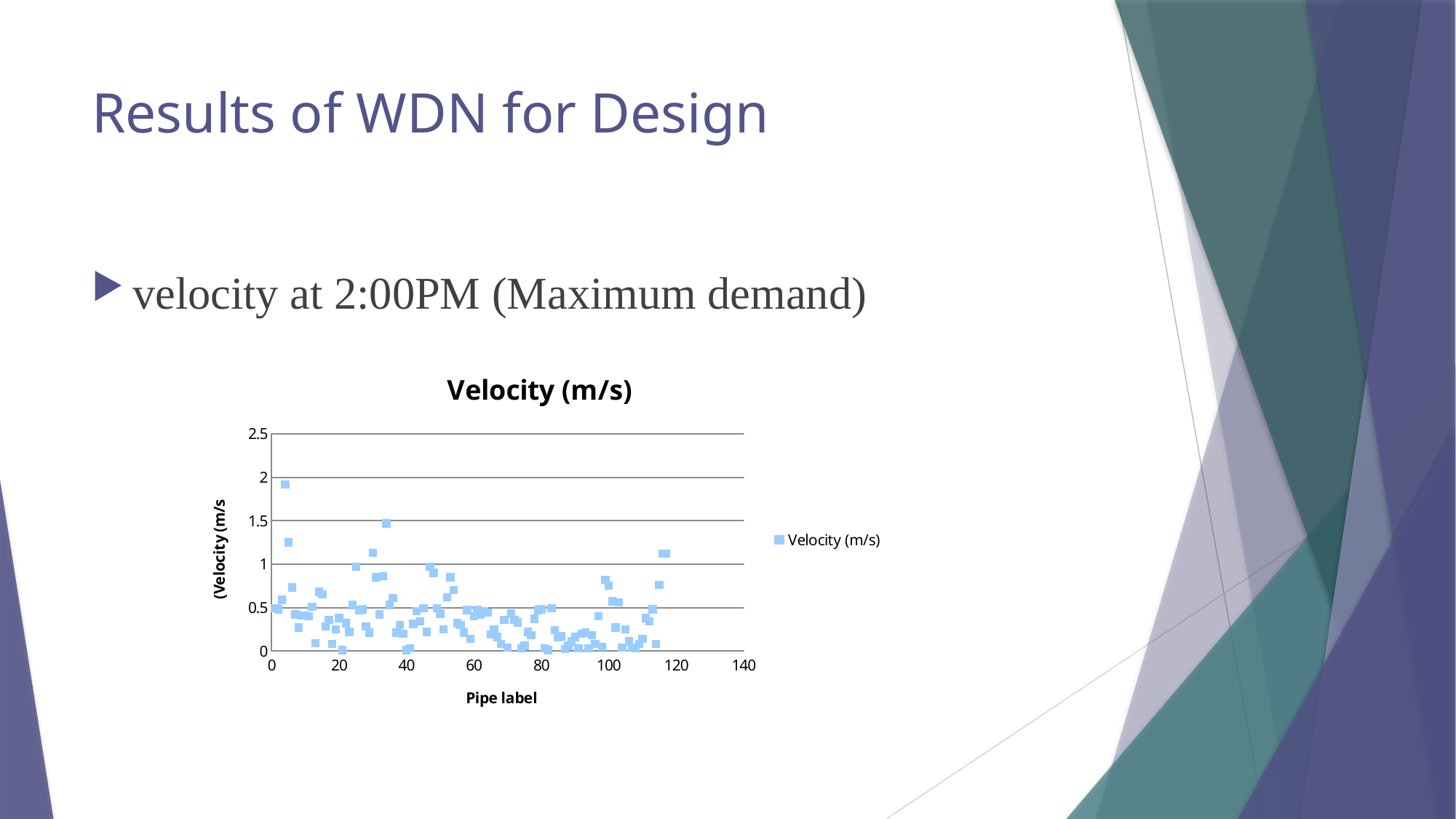
How many series does the chart legend list? 1 Is the highest plotted velocity value greater or less than 1.5? greater Are the velocity values for the pipes plotted between pipe labels 60 and 80 greater or less than 1? less Is the highest plotted velocity value greater or less than 2? less Is the highest velocity point located near the low end or the high end of the pipe label axis? low end What is the label of the x axis of the chart? Pipe label What kind of chart is shown on the slide? Scatter chart What is the title of the chart? Velocity (m/s)